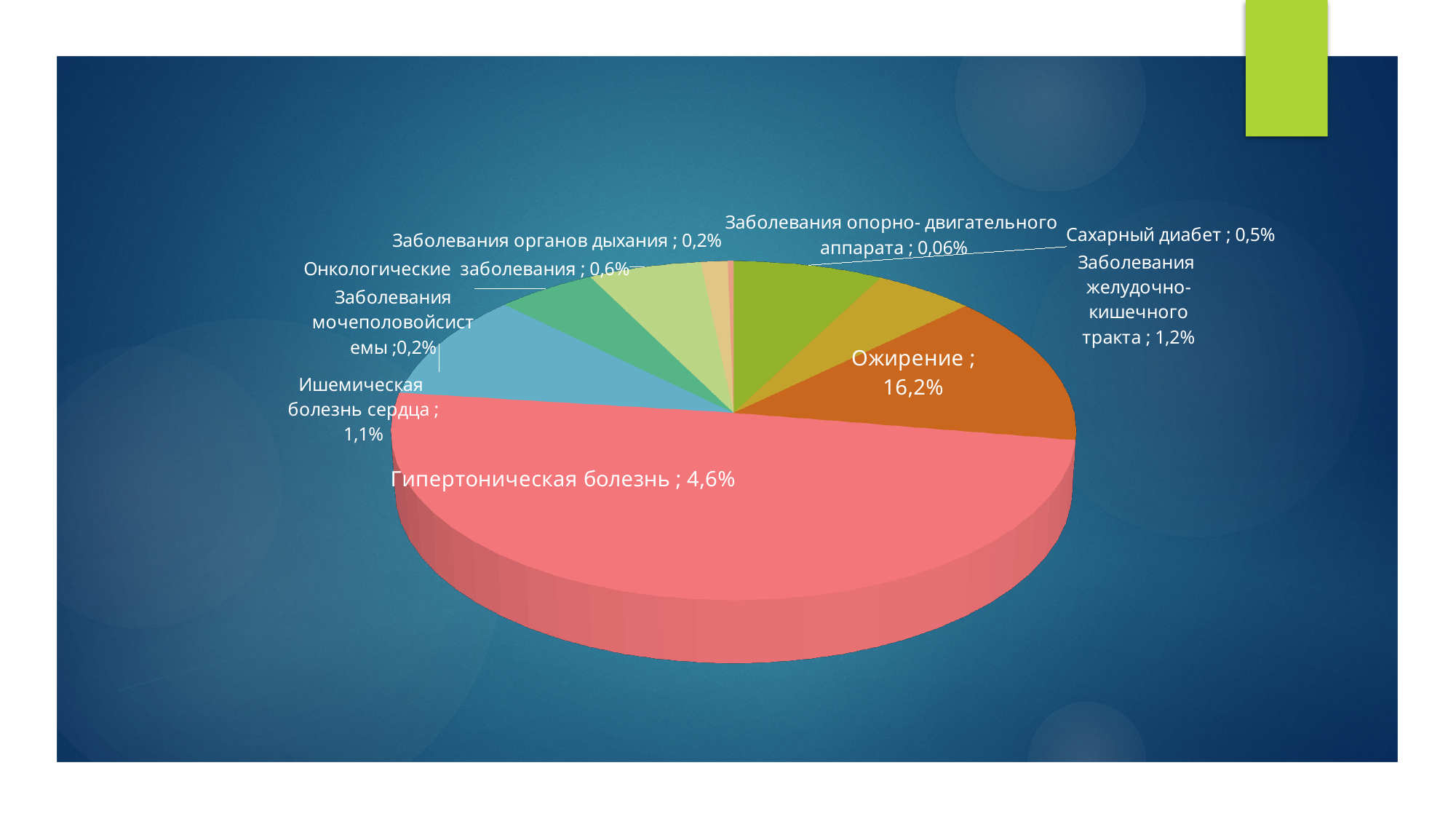
Which has the larger labelled value, Онкологические заболевания or Сахарный диабет? Онкологические заболевания What colour is the Ожирение slice? Orange What is the value shown for Ишемическая болезнь сердца? 1,1% What is the value shown for Гипертоническая болезнь? 4,6% What is the value shown for Сахарный диабет? 0,5% What kind of chart is shown on the slide? Pie chart Which category has the smallest labelled value? Заболевания опорно-двигательного аппарата What is the value shown for Ожирение? 16,2% How many categories does the pie chart show? 9 What is the value shown for Заболевания желудочно-кишечного тракта? 1,2% What is the difference between the labelled values for Ожирение and Гипертоническая болезнь? 11,6% What is the value shown for Онкологические заболевания? 0,6%